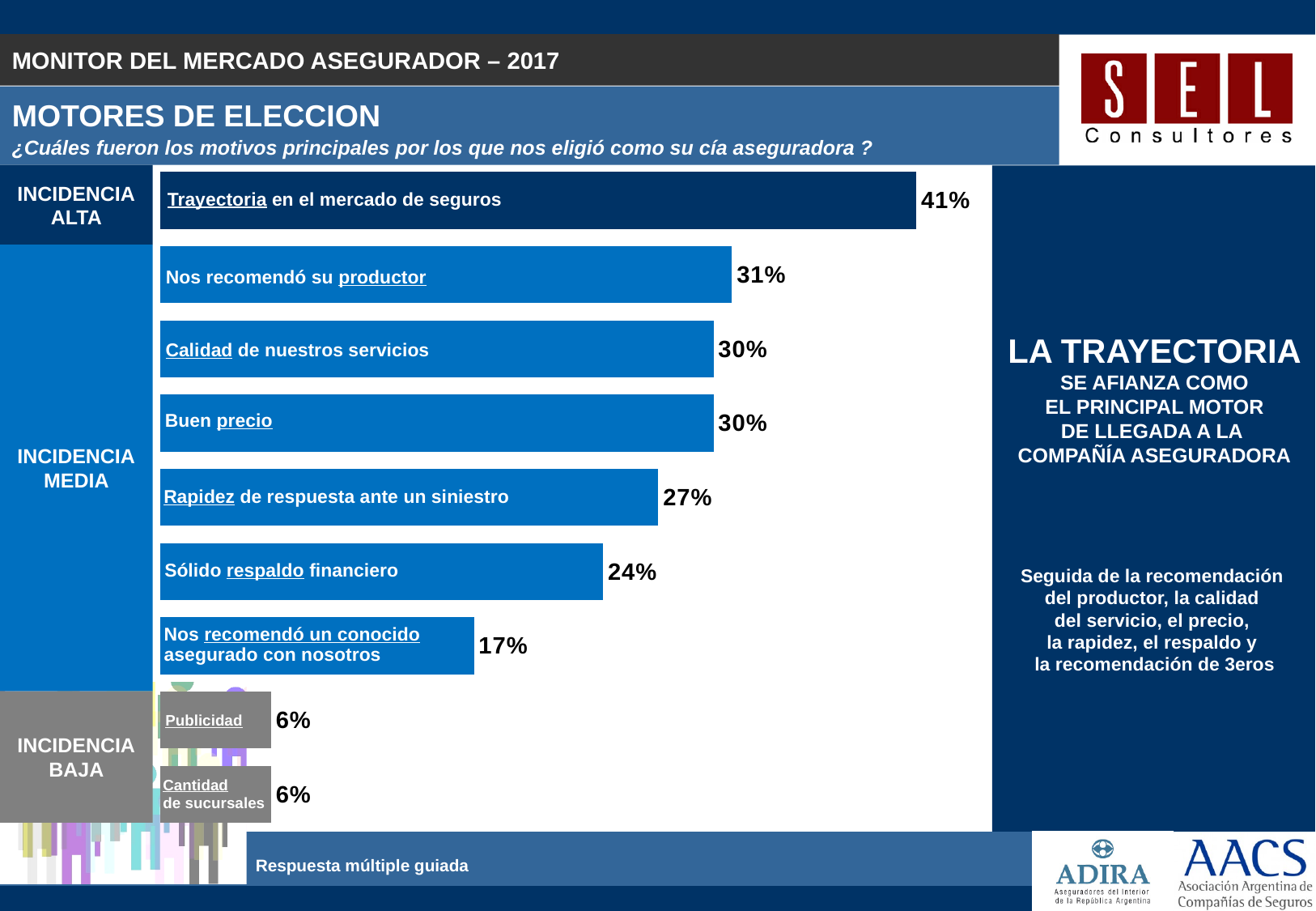
What is the difference in percentage points between "Sólido respaldo financiero" and "Nos recomendó un conocido asegurado con nosotros"? 7 percentage points What is the difference in percentage points between "Trayectoria en el mercado de seguros" and "Nos recomendó su productor"? 10 percentage points Which reason has the highest percentage in the chart? Trayectoria en el mercado de seguros What percentage is shown for "Trayectoria en el mercado de seguros"? 41% What percentage is shown for "Publicidad"? 6% Which incidence group (Incidencia) does "Cantidad de sucursales" belong to? Incidencia Baja What percentage is shown for "Nos recomendó su productor"? 31% What kind of chart is shown on the slide? Bar chart Which is larger: the value for "Rapidez de respuesta ante un siniestro" or for "Sólido respaldo financiero"? Rapidez de respuesta ante un siniestro How many reasons (bars) are shown in the chart? 9 What percentage is shown for "Nos recomendó un conocido asegurado con nosotros"? 17% What percentage is shown for "Rapidez de respuesta ante un siniestro"? 27%